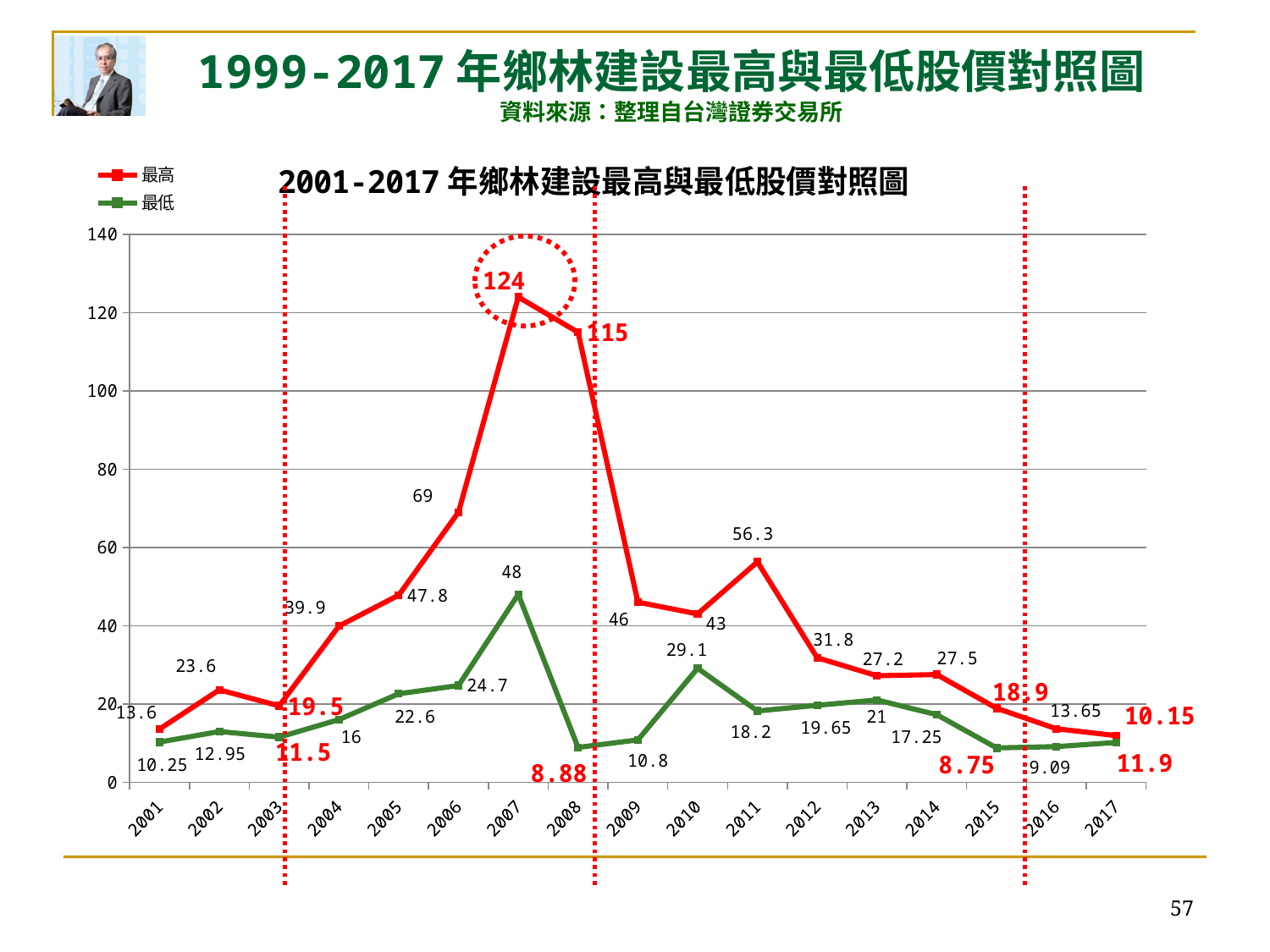
What is the 最低 value for 2010? 29.1 What is the difference between the 最高 and 最低 values in 2007? 76 What is the 最低 value for 2008? 8.88 Does the 最高 series rise or fall from 2011 to 2015? fall How many years are plotted along the x axis? 17 What is the 最高 value for 2011? 56.3 What type of chart is shown on the slide? line chart Which is larger, the 最高 value for 2005 or the 最高 value for 2009? 2005 How many series does the legend list? 2 In which year is the 最低 series at its lowest? 2015 What is the 最高 value for 2007? 124 In which year is the 最高 series at its highest? 2007